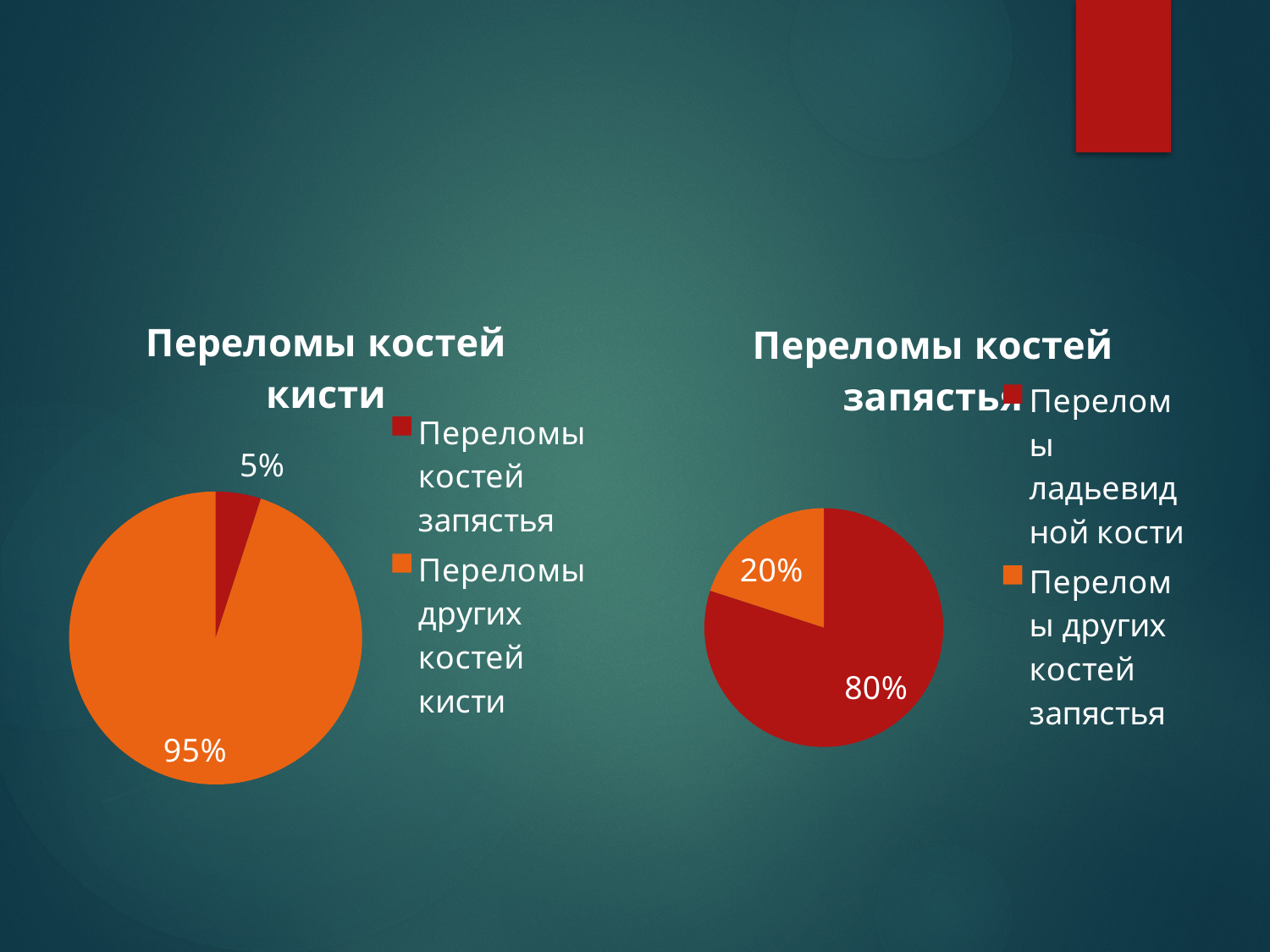
How many slices does the chart titled "Переломы костей запястья" have? 2 In the chart titled "Переломы костей кисти", what share is labelled for "Переломы костей запястья"? 5% In the chart titled "Переломы костей запястья", which is larger: "Переломы ладьевидной кости" or "Переломы других костей запястья"? Переломы ладьевидной кости In the chart titled "Переломы костей кисти", what is the difference in percentage points between the two slices? 90 In the chart titled "Переломы костей кисти", what share is labelled for "Переломы других костей кисти"? 95% In the chart titled "Переломы костей запястья", what share is labelled for "Переломы других костей запястья"? 20% In the chart titled "Переломы костей запястья", which slice is the smallest? Переломы других костей запястья How many charts are shown on the slide? 2 In the chart titled "Переломы костей кисти", which slice is the largest? Переломы других костей кисти In the chart titled "Переломы костей запястья", what is the difference in percentage points between the two slices? 60 What type of chart is the chart titled "Переломы костей кисти"? Pie chart In the chart titled "Переломы костей запястья", what share is labelled for "Переломы ладьевидной кости"? 80%